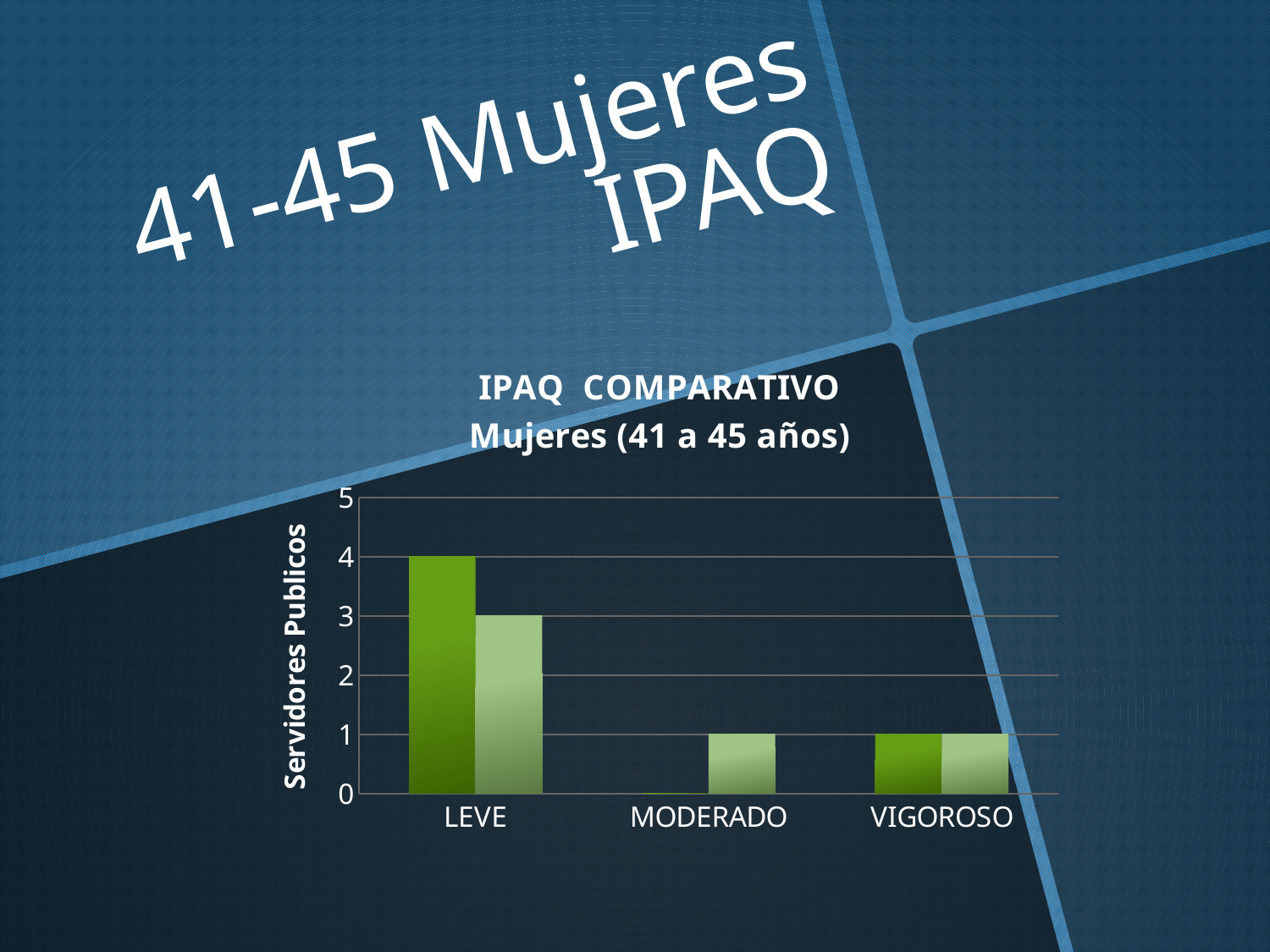
What type of chart is shown on the slide? bar chart What is the difference between the dark green and light green bars for LEVE? 1 What is the value of the dark green bar for VIGOROSO? 1 Which category has the lowest light green bar? MODERADO and VIGOROSO (both 1) What is the value of the light green bar for LEVE? 3 What is the value of the light green bar for MODERADO? 1 Which is larger for LEVE, the dark green bar or the light green bar? dark green bar Which category has the highest dark green bar? LEVE What is the title of the chart? IPAQ COMPARATIVO Mujeres (41 a 45 años) How many categories are shown on the x axis? 3 What is the label of the vertical axis? Servidores Publicos What is the value of the dark green bar for LEVE? 4